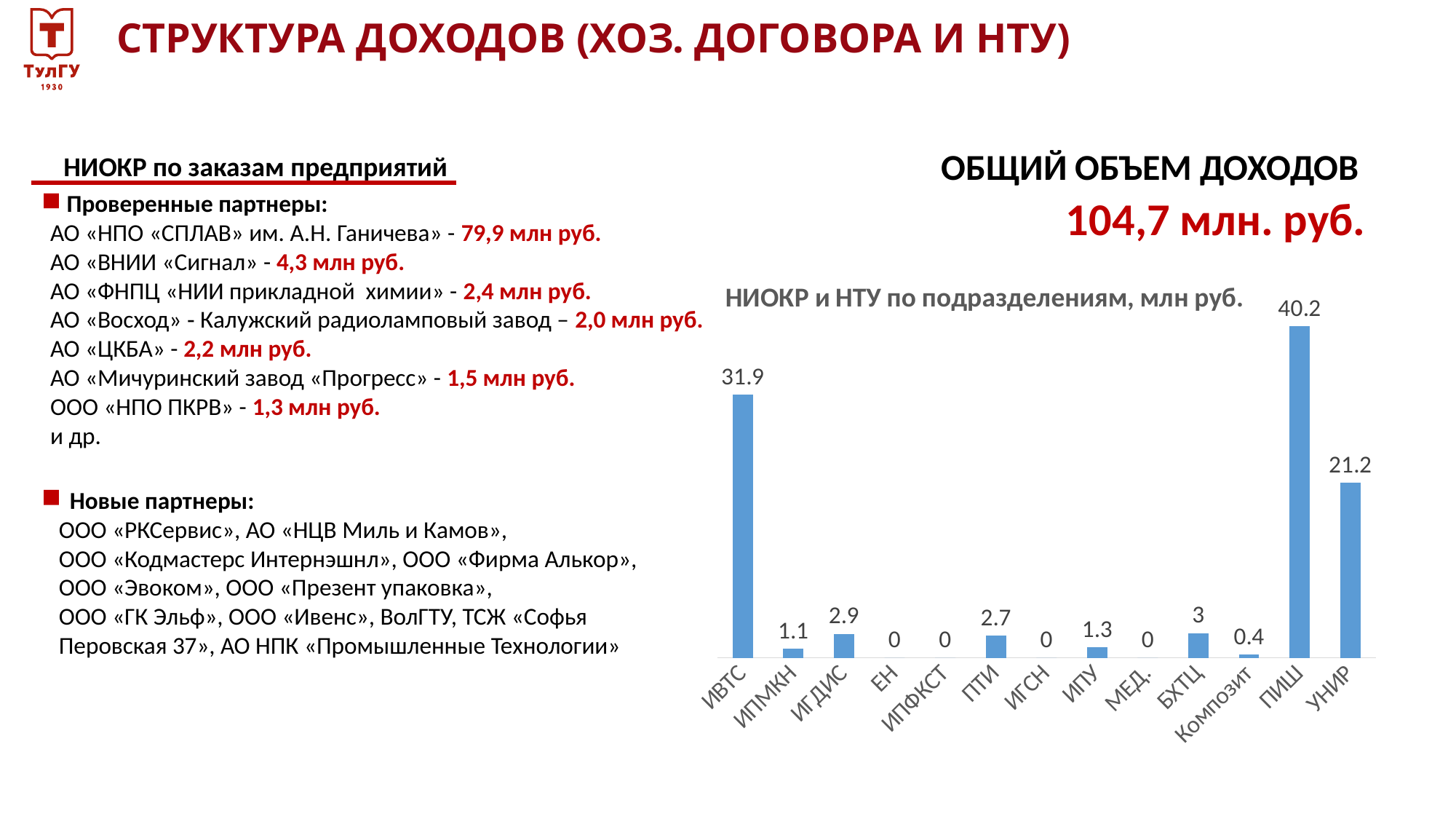
Which is larger, the value for ИГДИС or the value for ПТИ? ИГДИС What is the value for ПИШ in the chart? 40.2 What is the value for Композит in the chart? 0.4 What is the value for ИВТС in the chart? 31.9 Which is larger, the value for БХТЦ or the value for ИПУ? БХТЦ What is the value for УНИР in the chart? 21.2 What is the difference between the values for ИВТС and УНИР? 10.7 Which division has the highest value in the chart? ПИШ How many divisions are shown on the x axis of the chart? 13 What is the difference between the values for ПИШ and ИВТС? 8.3 What kind of chart is shown on the slide? Bar chart What is the title of the chart? НИОКР и НТУ по подразделениям, млн руб.